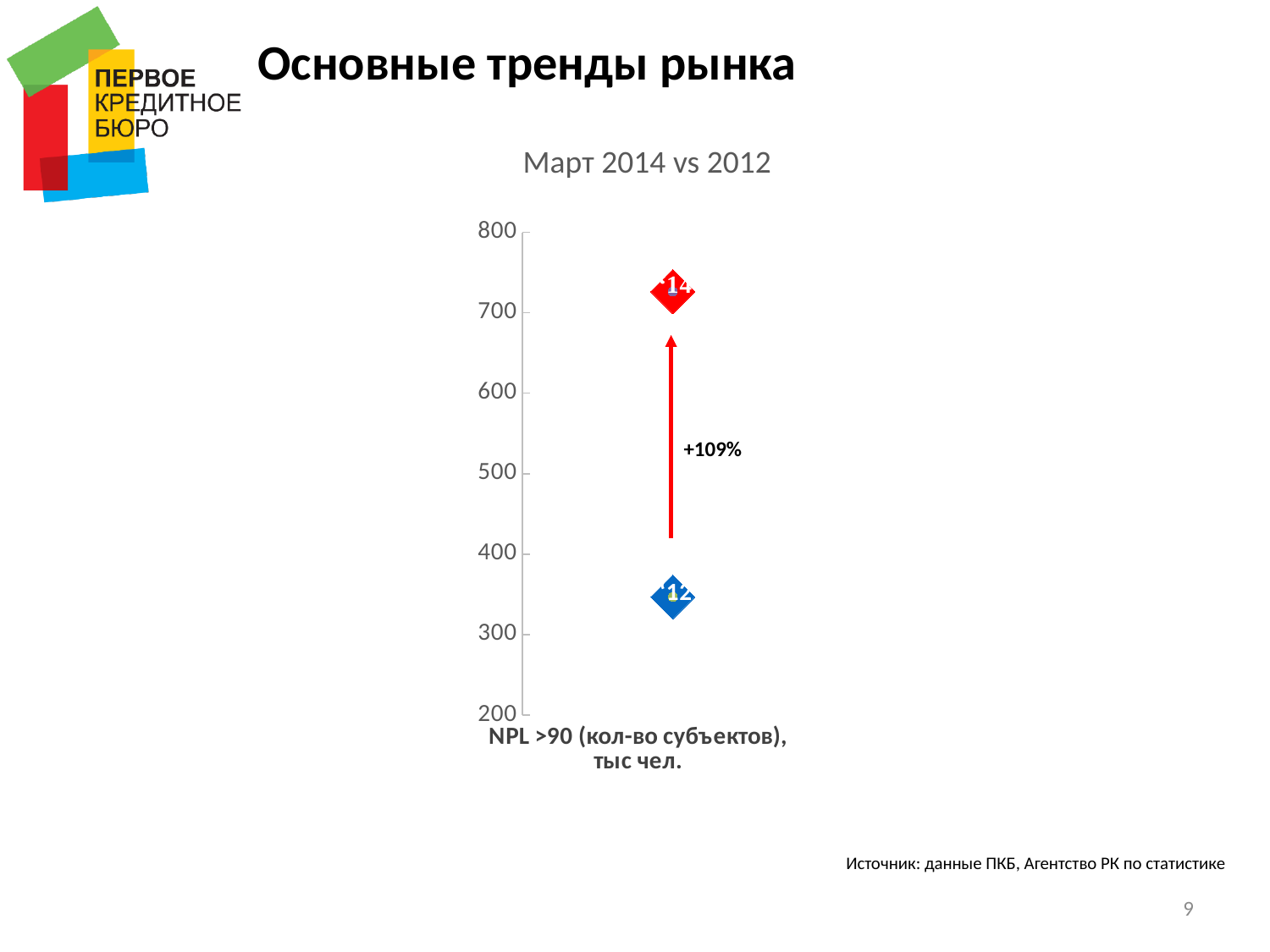
Which year has the higher value for NPL >90 (кол-во субъектов), тыс чел.: 2014 or 2012? 2014 What percentage change is printed next to the arrow between the 2012 and 2014 markers? +109% Is the value for 2014 greater or less than 600? greater Which year's marker is the lowest on the chart? 2012 What is the category label on the x axis of the chart? NPL >90 (кол-во субъектов), тыс чел. What is the lowest value shown on the y axis of the chart? 200 How many categories are shown on the x axis of the chart? 1 What is the title of the chart? Март 2014 vs 2012 Is the value for 2012 greater or less than 300? greater Is the value for 2012 greater or less than 400? less What is the highest value shown on the y axis of the chart? 800 Do the values rise or fall from 2012 to 2014? rise